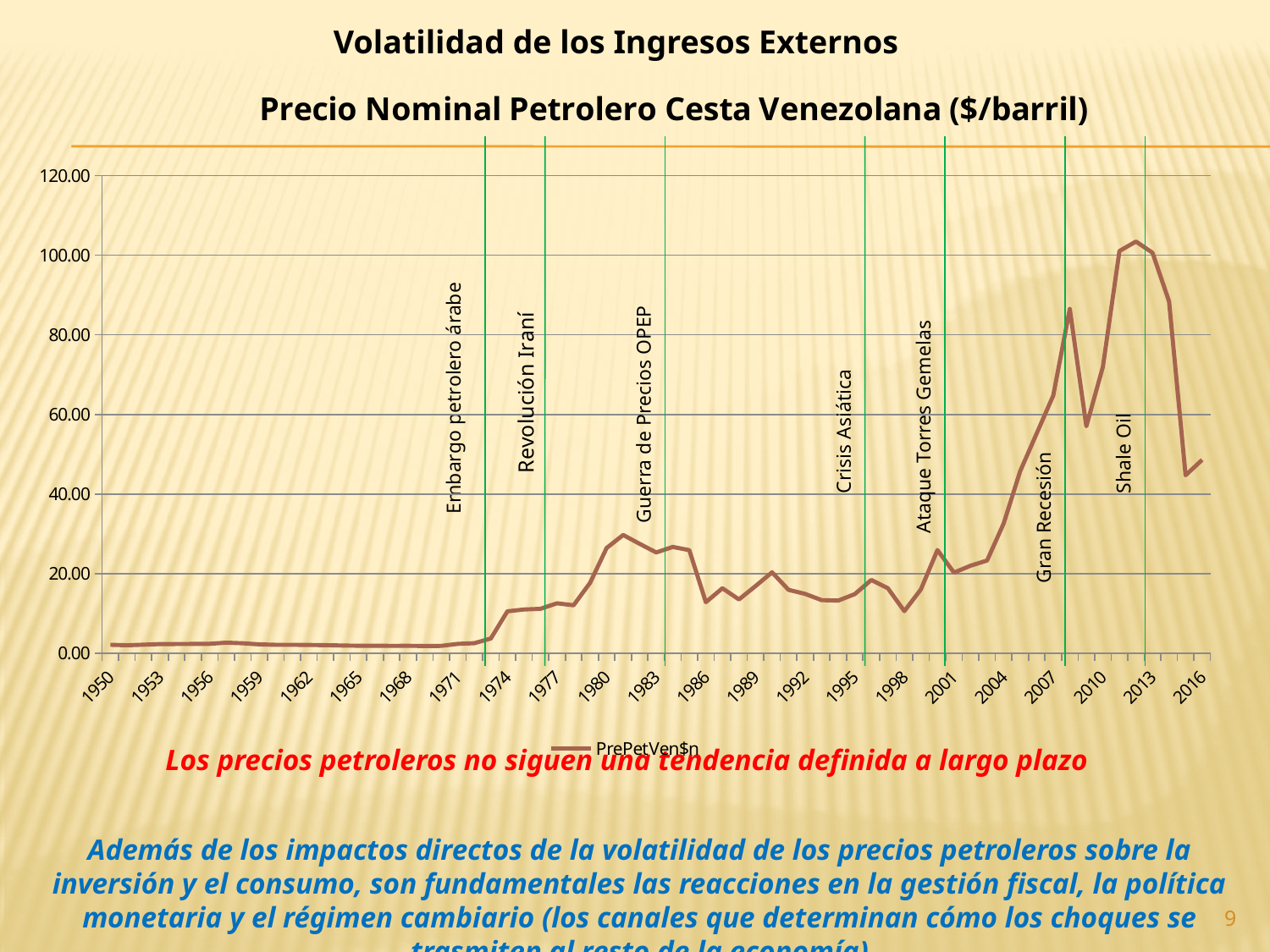
How many series does the legend list? 1 Is the value for 1981 greater or less than 20.00? greater What is the title of the chart? Precio Nominal Petrolero Cesta Venezolana ($/barril) Do the values rise or fall between 2004 and 2008? rise Is the value for 2012 greater or less than 80.00? greater Do the values rise or fall between 2013 and 2015? fall What kind of chart is shown on the slide? line chart What is the name of the series shown in the legend? PrePetVen$n Is the value for 1998 greater or less than 20.00? less